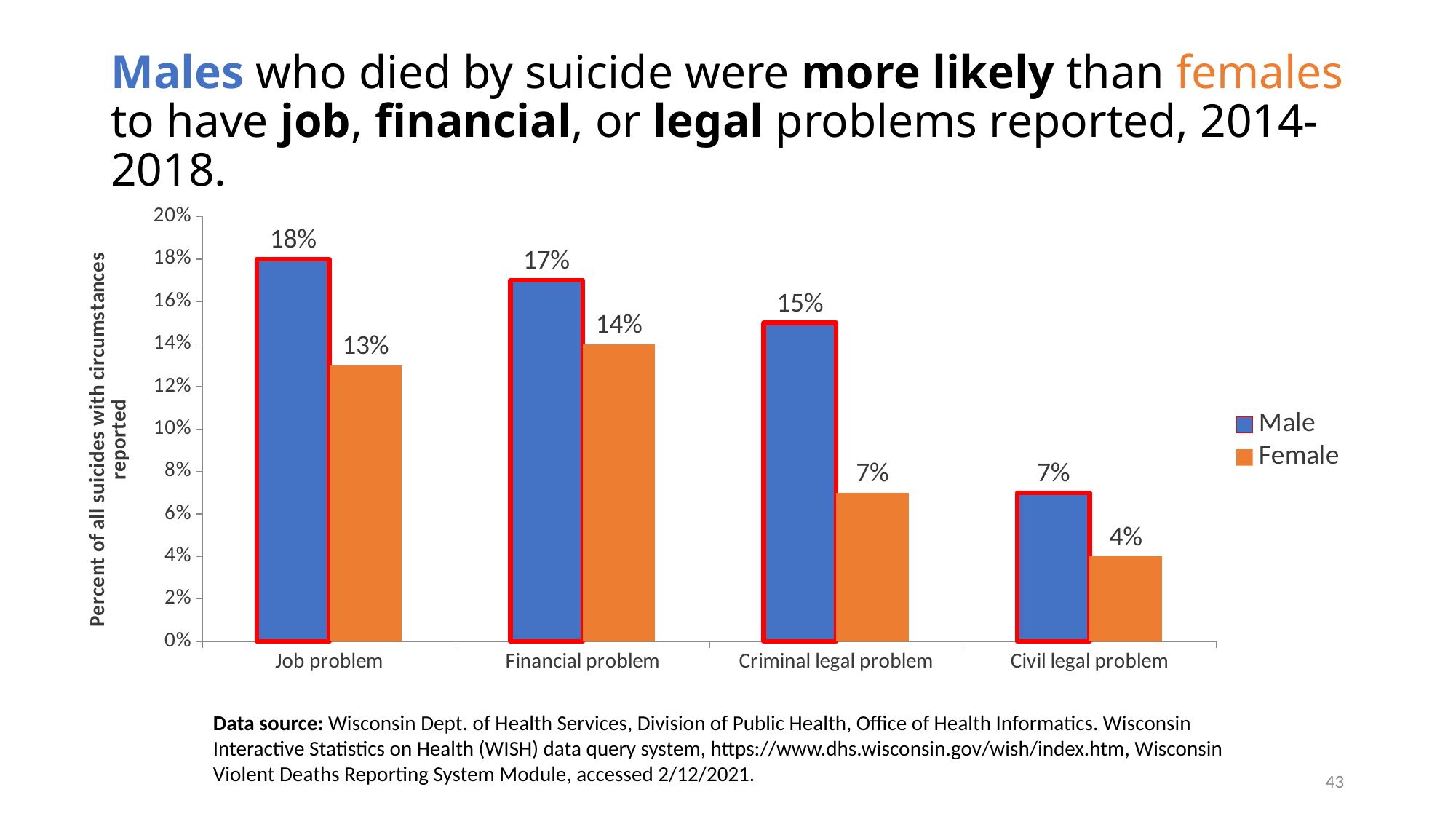
How many series does the legend list? 2 What is the Female value for Civil legal problem? 4% What is the Female value for Financial problem? 14% What is the Male value for Criminal legal problem? 15% Which category has the lowest Female value? Civil legal problem How many categories are shown on the x axis? 4 What is the label of the vertical axis? Percent of all suicides with circumstances reported What is the difference between the Male and Female values for Criminal legal problem? 8% What kind of chart is shown on the slide? Bar chart Which category has the highest Male value? Job problem What is the Male value for Job problem? 18% Which is larger for Job problem, the Male value or the Female value? Male